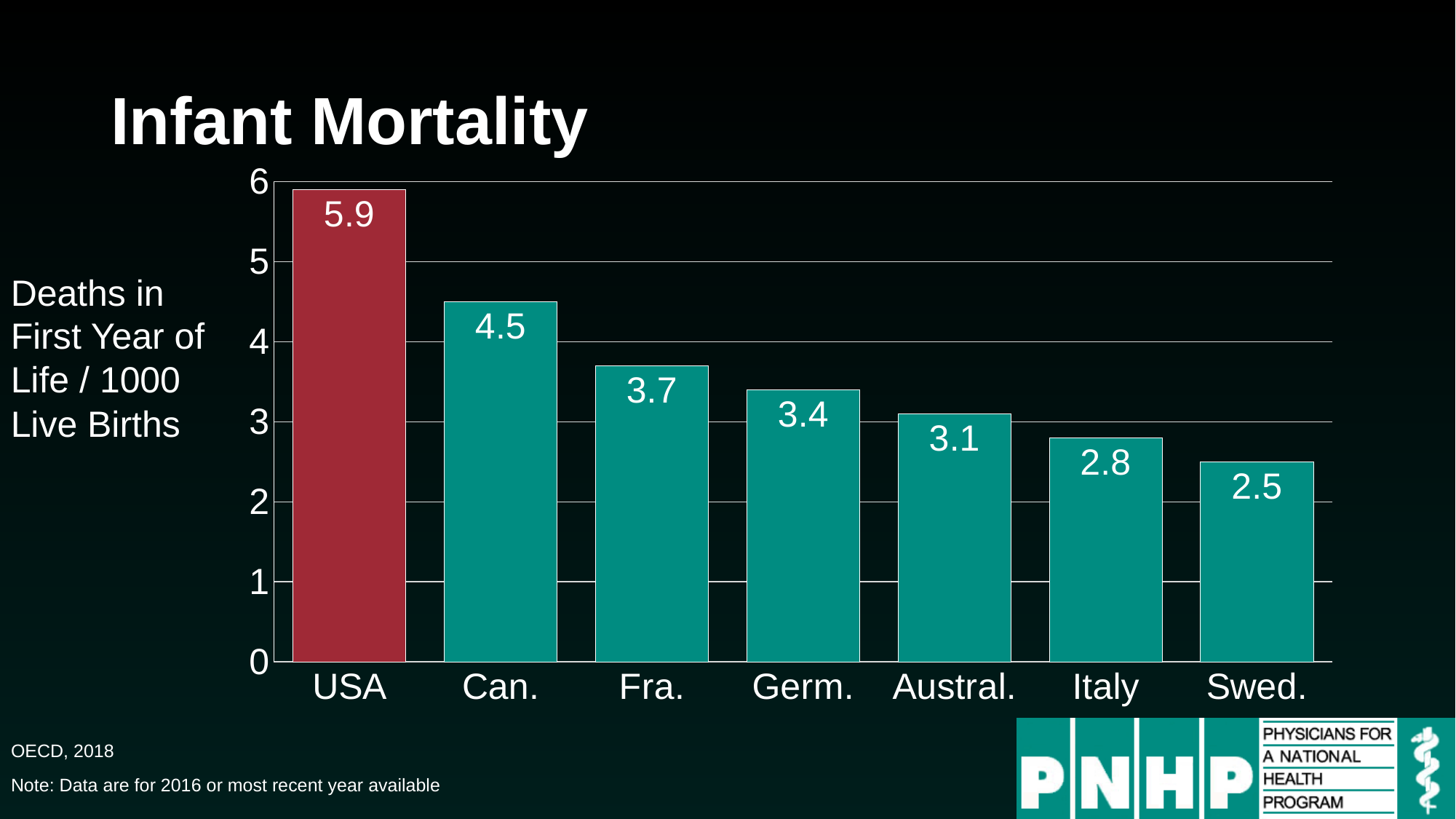
What kind of chart is shown on the slide? Bar chart Which country has the highest infant mortality on the chart? USA What is the infant mortality value shown for the USA? 5.9 Do the values rise or fall from left to right across the chart? Fall What is the value shown for Germ.? 3.4 How many countries are shown on the chart? 7 Which has a larger value, Austral. or Germ.? Germ. What is the value shown for Swed.? 2.5 Is the value for Can. greater or less than 4? greater Which country has the lowest infant mortality on the chart? Swed. What is the difference between the values for the USA and Can.? 1.4 What is the difference between the values for Fra. and Italy? 0.9